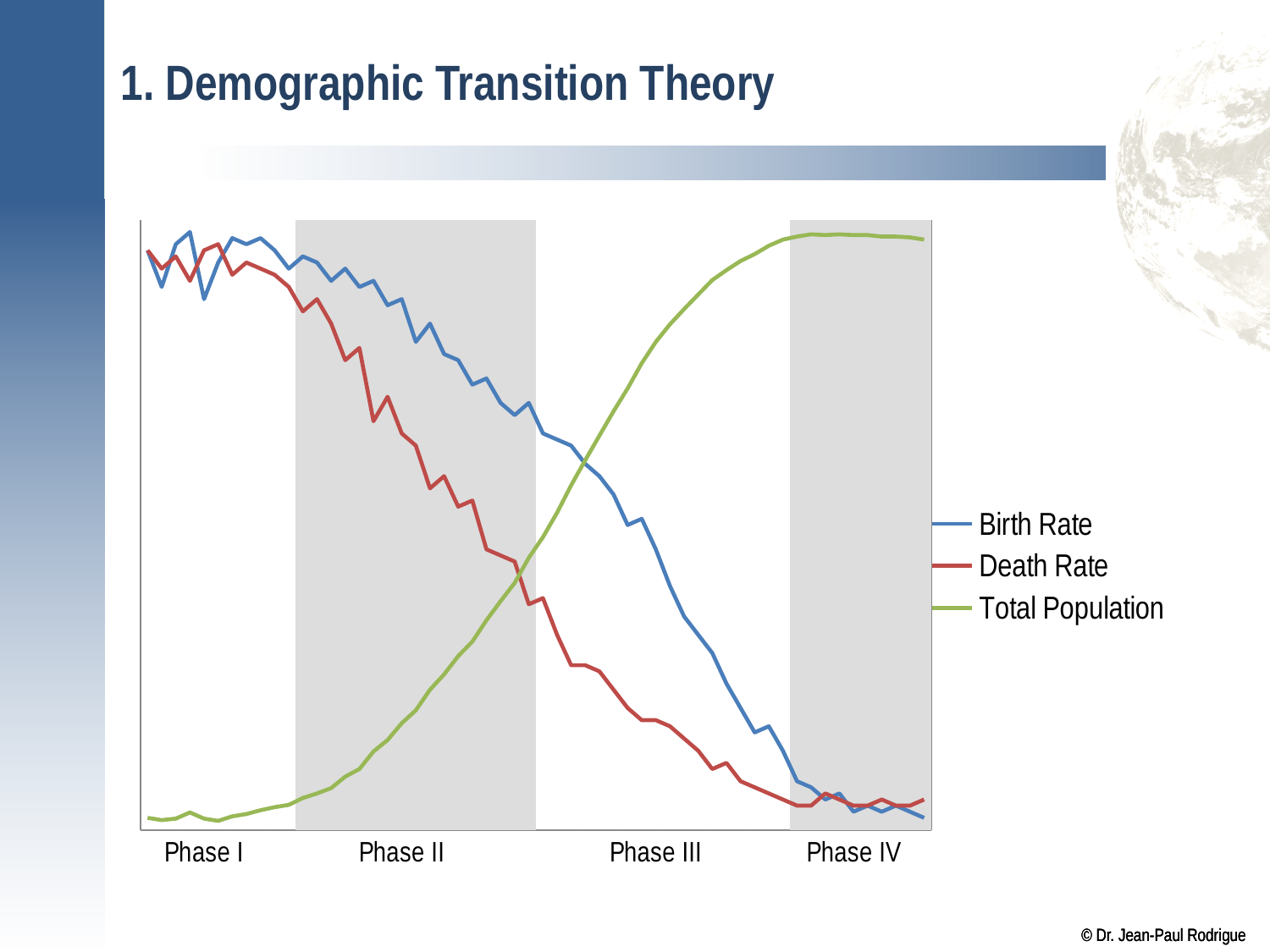
Does the Death Rate line rise or fall across the chart from left to right? Falls In Phase IV, which series has the highest values? Total Population What kind of chart is shown on the slide? Line chart In Phase II, which is higher, the Birth Rate or the Death Rate? Birth Rate Does the Birth Rate line rise or fall from Phase I to Phase IV? Falls Which phase is labelled furthest to the right on the x axis? Phase IV How many series does the legend list? 3 How many phases are labelled along the x axis? 4 In which phase does the Total Population line cross above the Birth Rate line? Phase III Does the Total Population line rise or fall from Phase I to Phase IV? Rises In Phase I, which series has the lowest values, Birth Rate, Death Rate or Total Population? Total Population What colour is the Death Rate line? Red